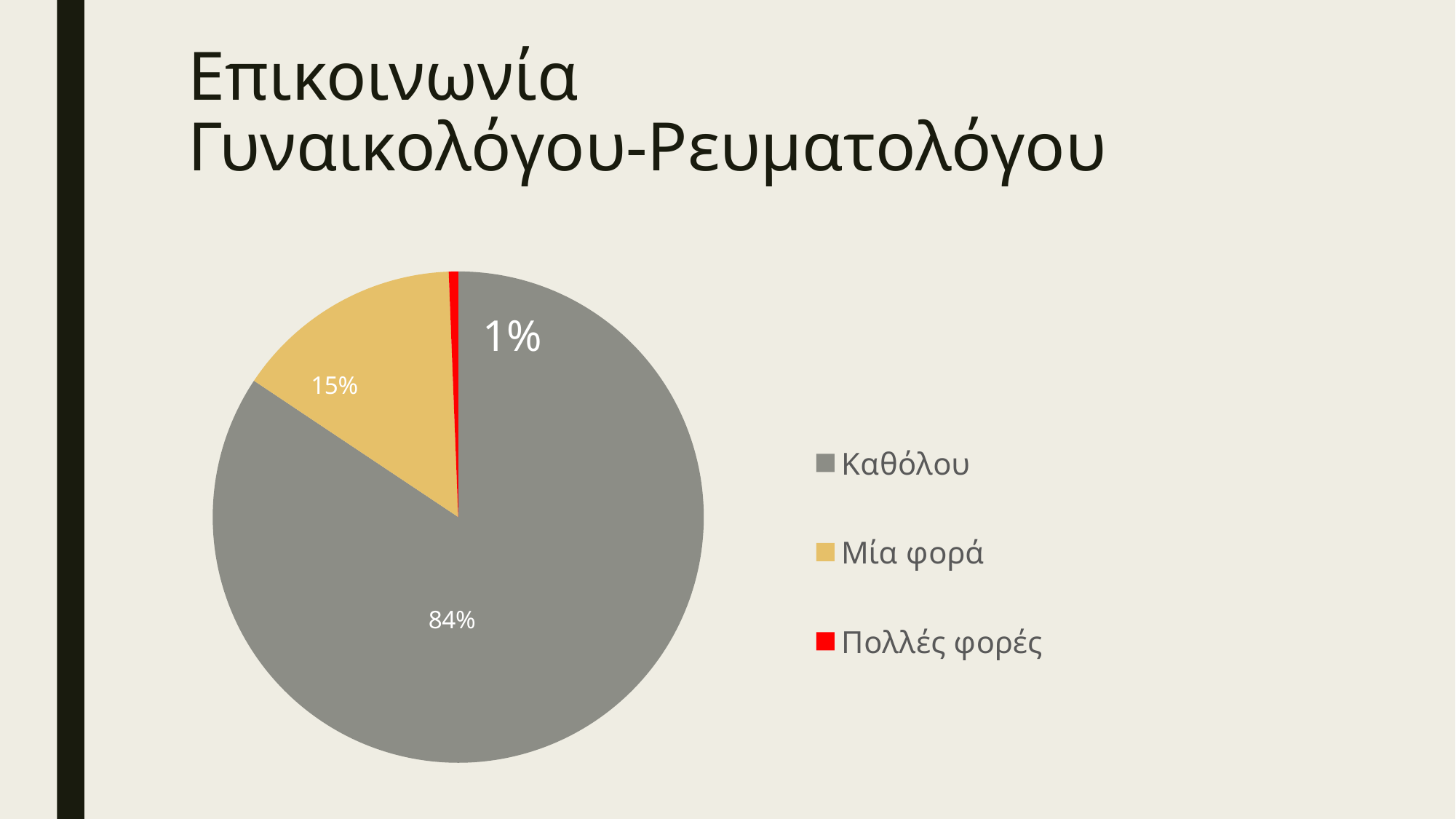
What is the difference between the shares of Μία φορά and Πολλές φορές? 14% What share of the pie does Πολλές φορές have? 1% What share of the pie does Καθόλου have? 84% Which category has the largest slice of the pie? Καθόλου What is the title of the slide containing the chart? Επικοινωνία Γυναικολόγου-Ρευματολόγου Which category has the smallest slice of the pie? Πολλές φορές What kind of chart is shown on the slide? pie chart What share of the pie does Μία φορά have? 15% Which is larger, the share for Μία φορά or the share for Πολλές φορές? Μία φορά What colour is the slice for Πολλές φορές? red How many categories does the pie chart have? 3 What is the difference between the shares of Καθόλου and Μία φορά? 69%